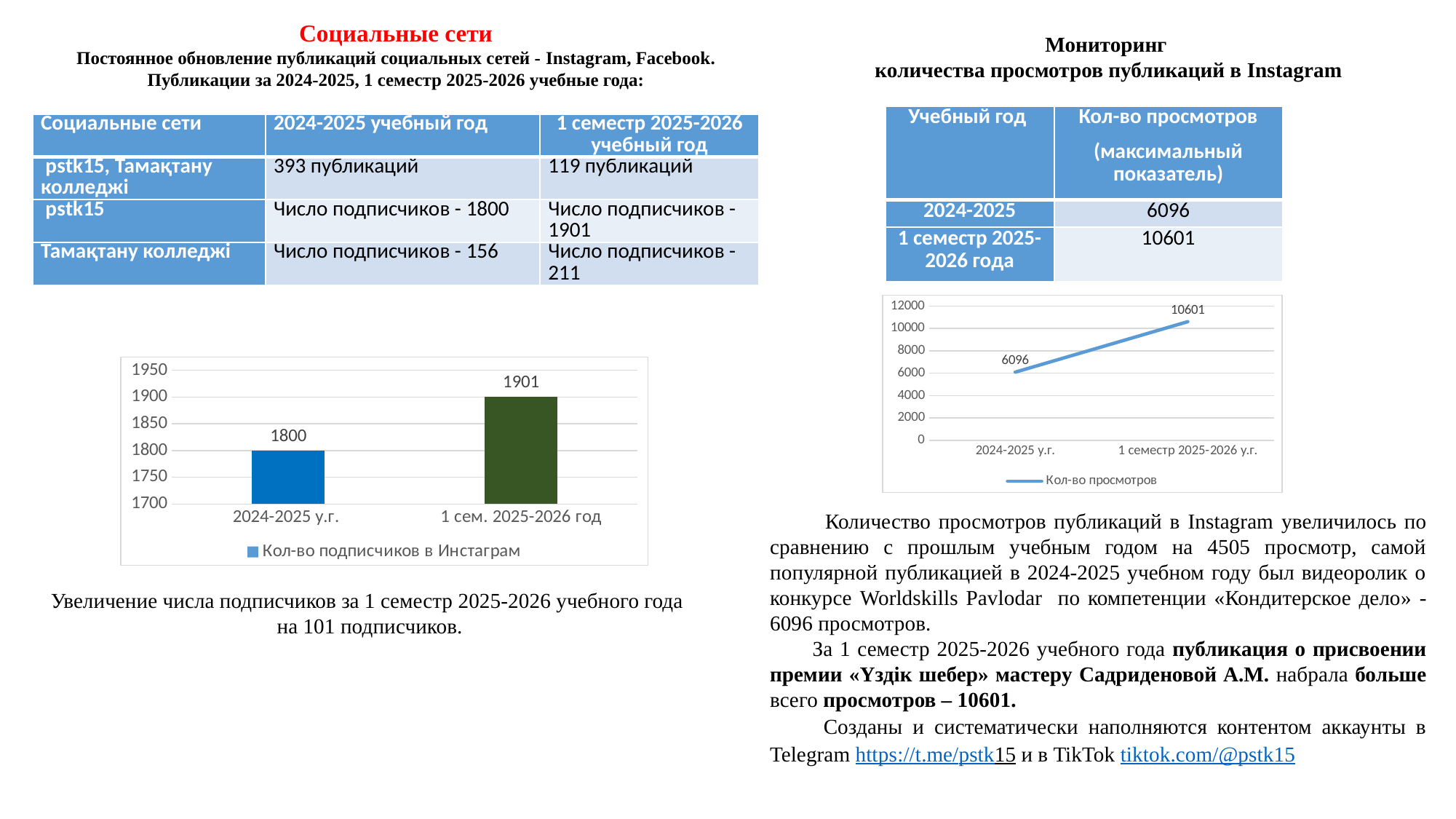
In the line chart on the right, what is the value for 1 семестр 2025-2026 у.г.? 10601 In the bar chart on the left, what is the difference between the values for 1 сем. 2025-2026 год and 2024-2025 у.г.? 101 In the line chart on the right, what is the difference between the values for 1 семестр 2025-2026 у.г. and 2024-2025 у.г.? 4505 In the line chart on the right, is the value for 2024-2025 у.г. greater or less than 8000? less How many data points are plotted in the line chart on the right? 2 In the bar chart on the left, which category has the higher value? 1 сем. 2025-2026 год In the bar chart on the left, what series name does the legend show? Кол-во подписчиков в Инстаграм In the bar chart on the left, what is the value for 2024-2025 у.г.? 1800 What type of chart is shown on the left side of the slide? bar chart In the bar chart on the left, what is the value for 1 сем. 2025-2026 год? 1901 In the line chart on the right, what is the value for 2024-2025 у.г.? 6096 In the line chart on the right, do the values rise or fall from 2024-2025 у.г. to 1 семестр 2025-2026 у.г.? rise